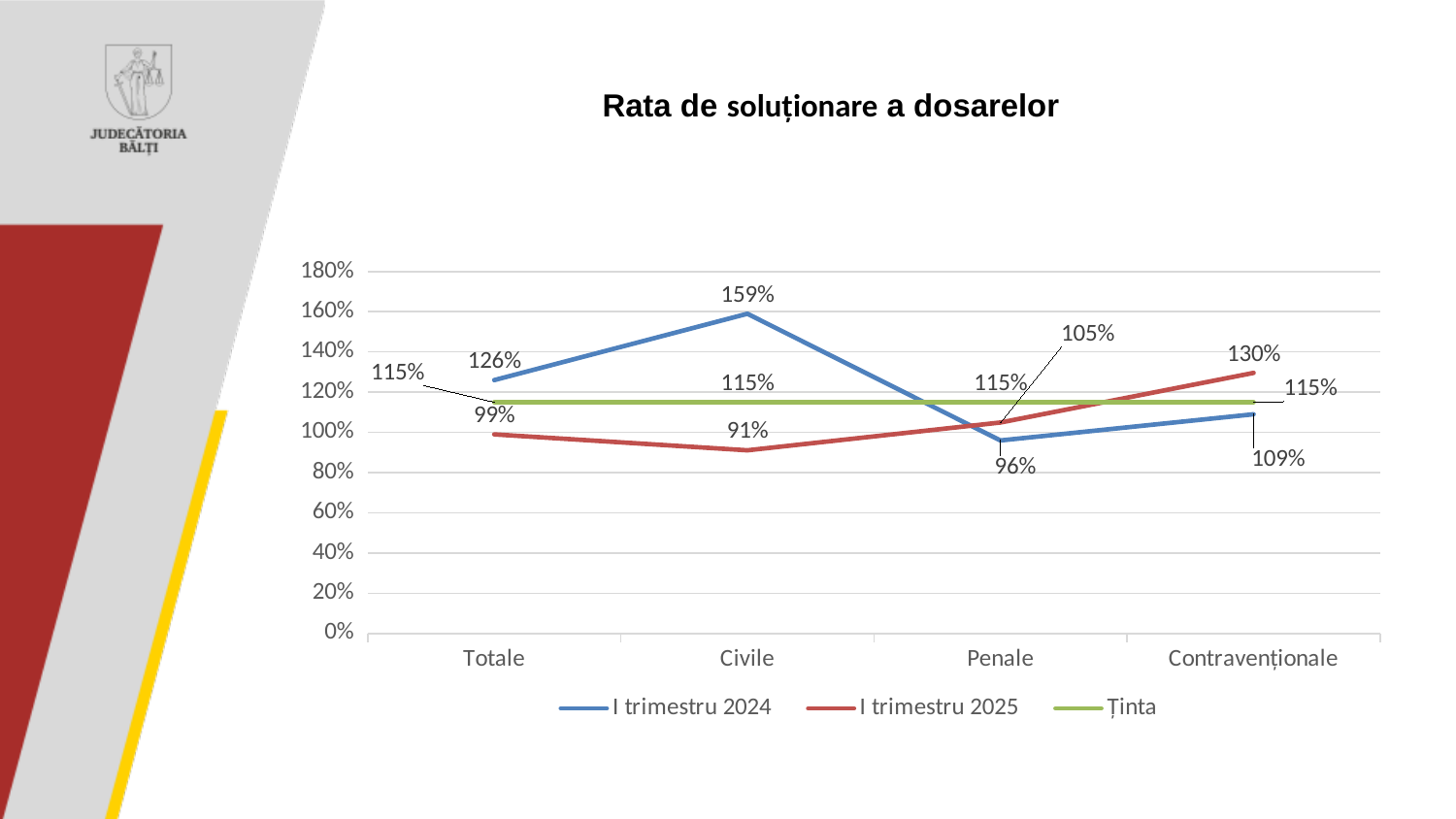
What is the value of the Ținta series for Penale? 115% Does the I trimestru 2025 series rise or fall from Civile to Contravenționale? rise What is the difference between the I trimestru 2024 and I trimestru 2025 values for Totale? 27% What is the title of the chart? Rata de soluționare a dosarelor For Penale, which series has the larger value, I trimestru 2024 or I trimestru 2025? I trimestru 2025 What type of chart is shown on the slide? line chart What is the value for Civile in the I trimestru 2024 series? 159% Which category has the lowest value in the I trimestru 2025 series? Civile How many categories are shown on the x axis? 4 Which category has the highest value in the I trimestru 2024 series? Civile What is the value for Contravenționale in the I trimestru 2025 series? 130% How many series does the legend list? 3